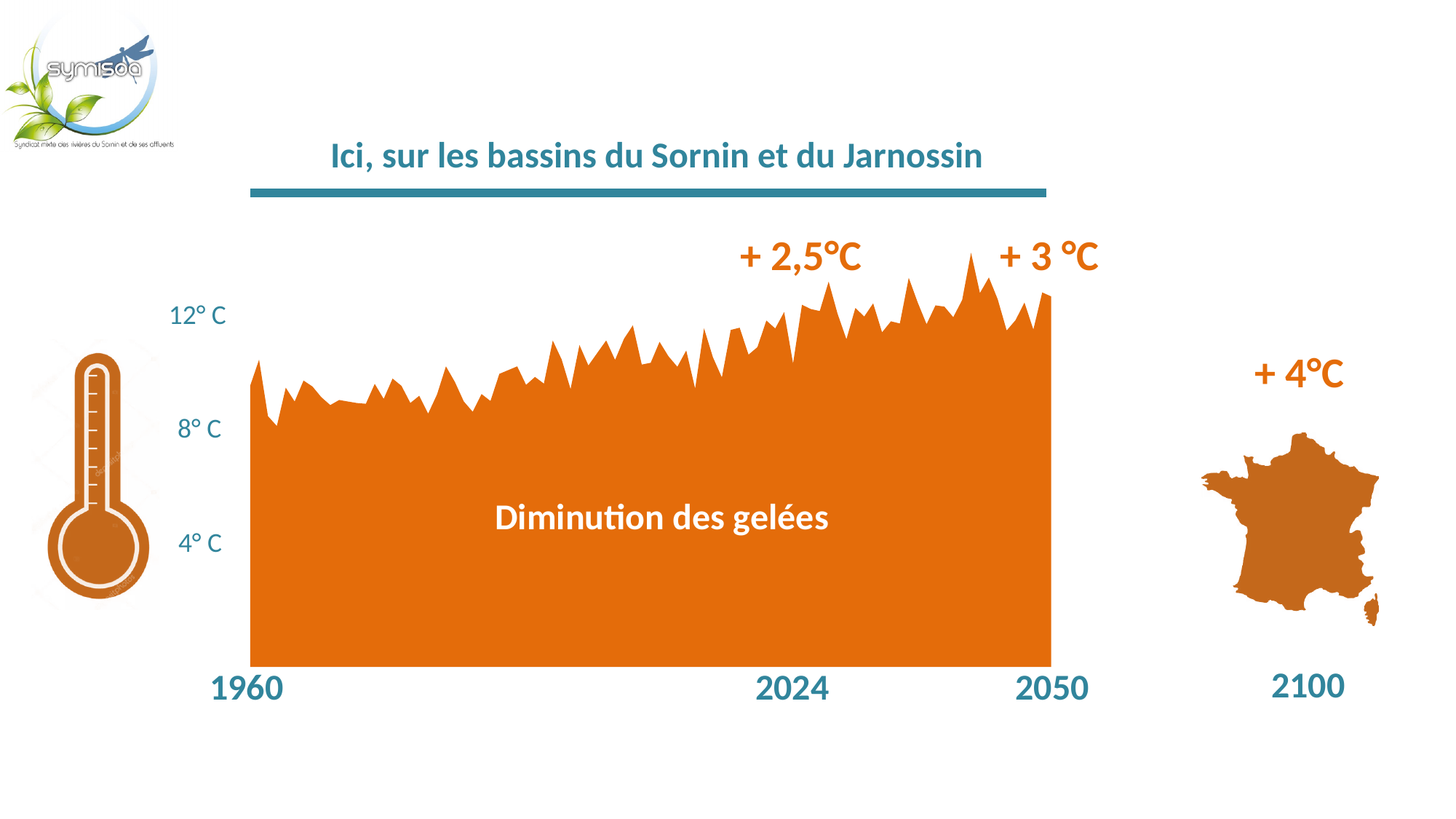
What temperature increase is annotated next to the map of France for 2100? + 4°C How many year labels are shown on the x axis of the area chart? 3 What kind of chart is shown on the slide? area chart Is the plotted value at 1960 greater or less than 12° C? less What temperature increase is annotated on the chart near 2024? + 2,5°C Is the plotted value at 1960 greater or less than 4° C? greater Which year shown on the x axis has the higher plotted temperature, 1960 or 2050? 2050 Do the plotted temperature values generally rise or fall from 1960 to 2050? rise What text is written inside the orange area of the chart? Diminution des gelées Is the plotted value at 2050 greater or less than 8° C? greater What temperature increase is annotated on the chart near 2050? + 3 °C What is the title above the chart? Ici, sur les bassins du Sornin et du Jarnossin